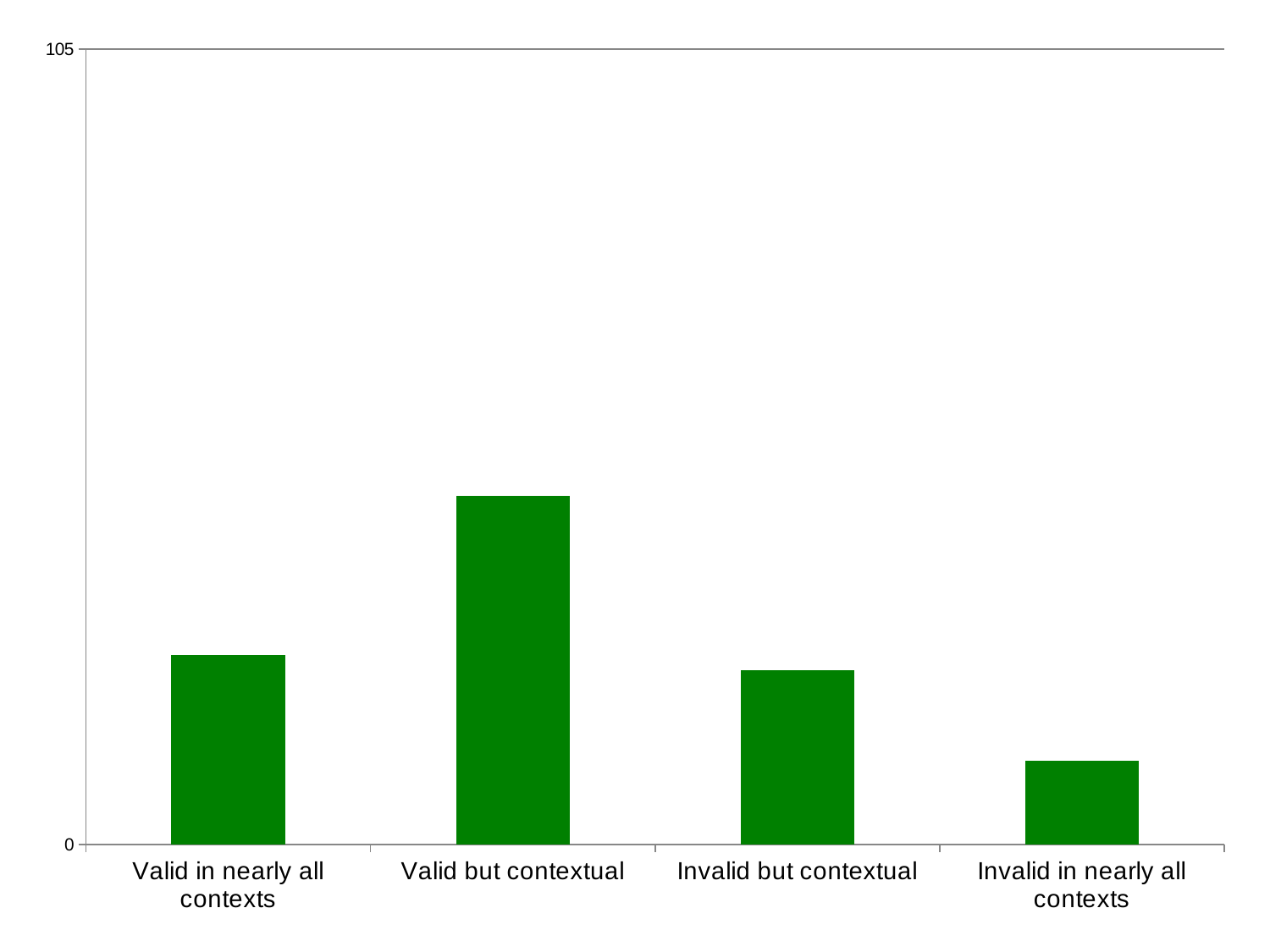
Which category has the highest bar? Valid but contextual Do the values rise or fall from Valid in nearly all contexts to Valid but contextual along the x axis? rise What kind of chart is shown on the slide? bar chart How many categories are shown on the x axis of the chart? 4 Which is larger, the value for Valid but contextual or the value for Invalid in nearly all contexts? Valid but contextual What colour are the bars in the chart? green Which is larger, the value for Valid in nearly all contexts or the value for Invalid in nearly all contexts? Valid in nearly all contexts Which is larger, the value for Valid but contextual or the value for Invalid but contextual? Valid but contextual Do the values rise or fall from Valid but contextual to Invalid in nearly all contexts along the x axis? fall Is the value for Valid but contextual greater or less than 105? less What is the highest value labelled on the vertical axis? 105 Which category has the lowest bar? Invalid in nearly all contexts